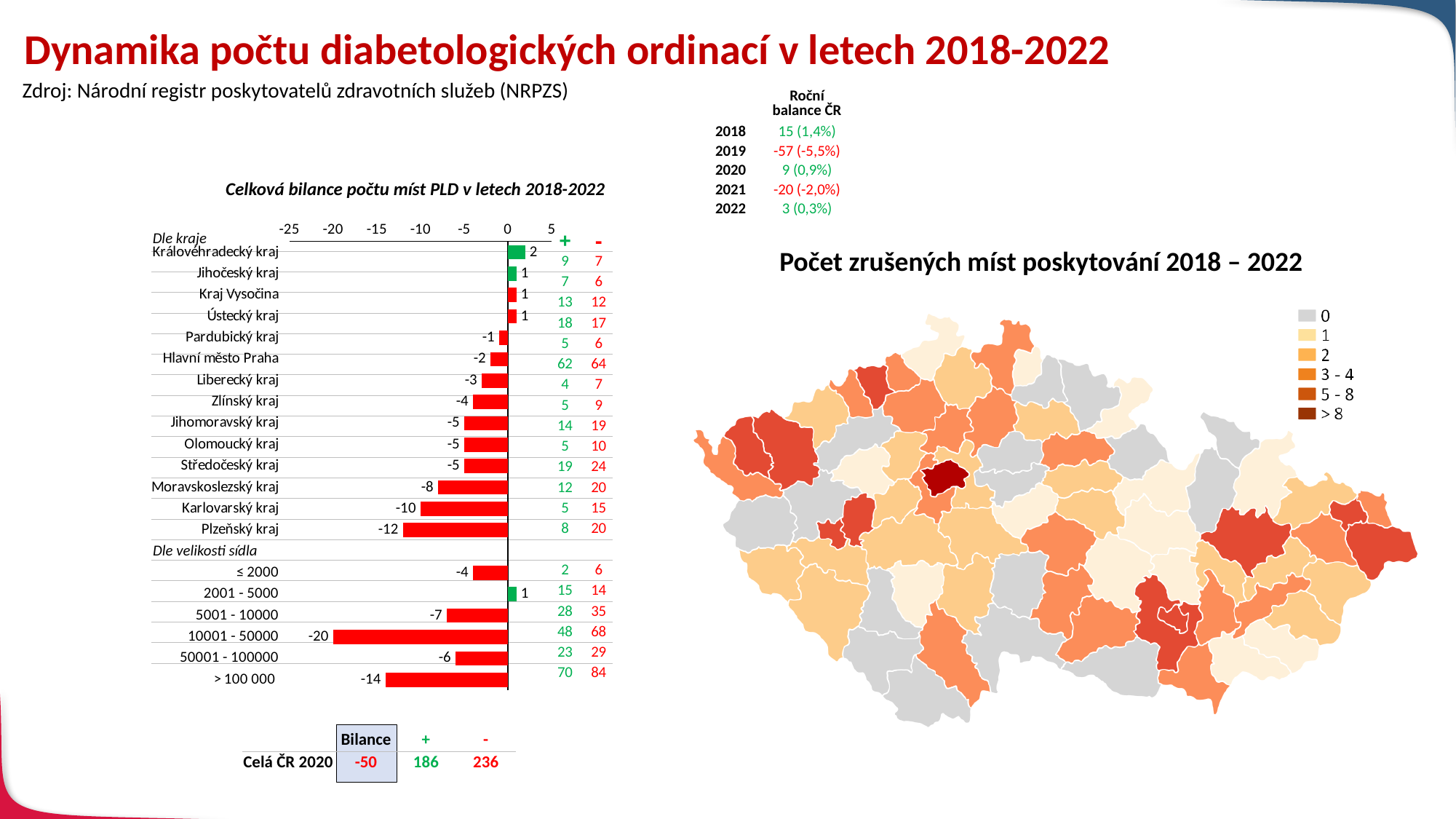
In the chart 'Celková bilance počtu míst PLD v letech 2018-2022', what is the difference between the values for Karlovarský kraj and Moravskoslezský kraj? 2 In the chart 'Celková bilance počtu míst PLD v letech 2018-2022', which region (kraj) has the lowest value? Plzeňský kraj In the chart 'Celková bilance počtu míst PLD v letech 2018-2022', how many size categories are listed under 'Dle velikosti sídla'? 6 In the chart 'Celková bilance počtu míst PLD v letech 2018-2022', what is the value for Královéhradecký kraj? 2 What type of chart is 'Celková bilance počtu míst PLD v letech 2018-2022'? Bar chart In the chart 'Celková bilance počtu míst PLD v letech 2018-2022', which region (kraj) has the highest value? Královéhradecký kraj How many legend entries does the map 'Počet zrušených míst poskytování 2018 – 2022' show? 6 In the chart 'Celková bilance počtu míst PLD v letech 2018-2022', what is the value for the size category 10001 - 50000? -20 In the chart 'Celková bilance počtu míst PLD v letech 2018-2022', how many regions (kraje) are listed under 'Dle kraje'? 14 In the chart 'Celková bilance počtu míst PLD v letech 2018-2022', which has the larger value, Liberecký kraj or Zlínský kraj? Liberecký kraj In the chart 'Celková bilance počtu míst PLD v letech 2018-2022', what is the value for Plzeňský kraj? -12 In the chart 'Celková bilance počtu míst PLD v letech 2018-2022', which size category (Dle velikosti sídla) has the lowest value? 10001 - 50000